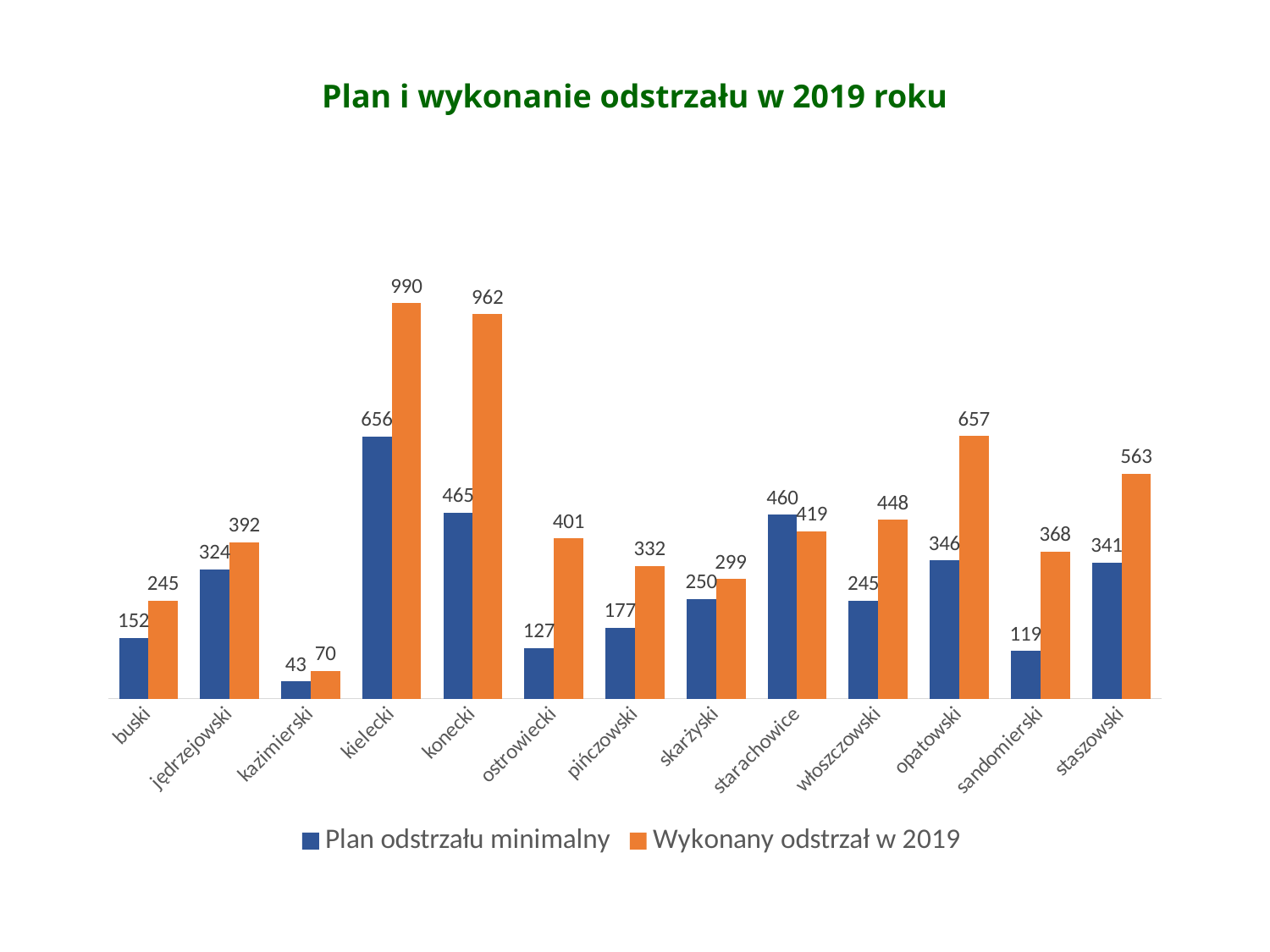
How many series does the legend list? 2 For starachowice, which is larger: "Plan odstrzału minimalny" or "Wykonany odstrzał w 2019"? Plan odstrzału minimalny What is the value of "Plan odstrzału minimalny" for konecki? 465 What is the value of "Wykonany odstrzał w 2019" for sandomierski? 368 How many categories are shown on the x axis? 13 What is the difference between "Wykonany odstrzał w 2019" and "Plan odstrzału minimalny" for opatowski? 311 What is the difference between "Wykonany odstrzał w 2019" and "Plan odstrzału minimalny" for kielecki? 334 Which is larger: "Wykonany odstrzał w 2019" for konecki or for opatowski? konecki Which category has the lowest value for "Plan odstrzału minimalny"? kazimierski Which category has the highest value for "Wykonany odstrzał w 2019"? kielecki What type of chart is shown on the slide? bar chart What is the value of "Wykonany odstrzał w 2019" for kielecki? 990